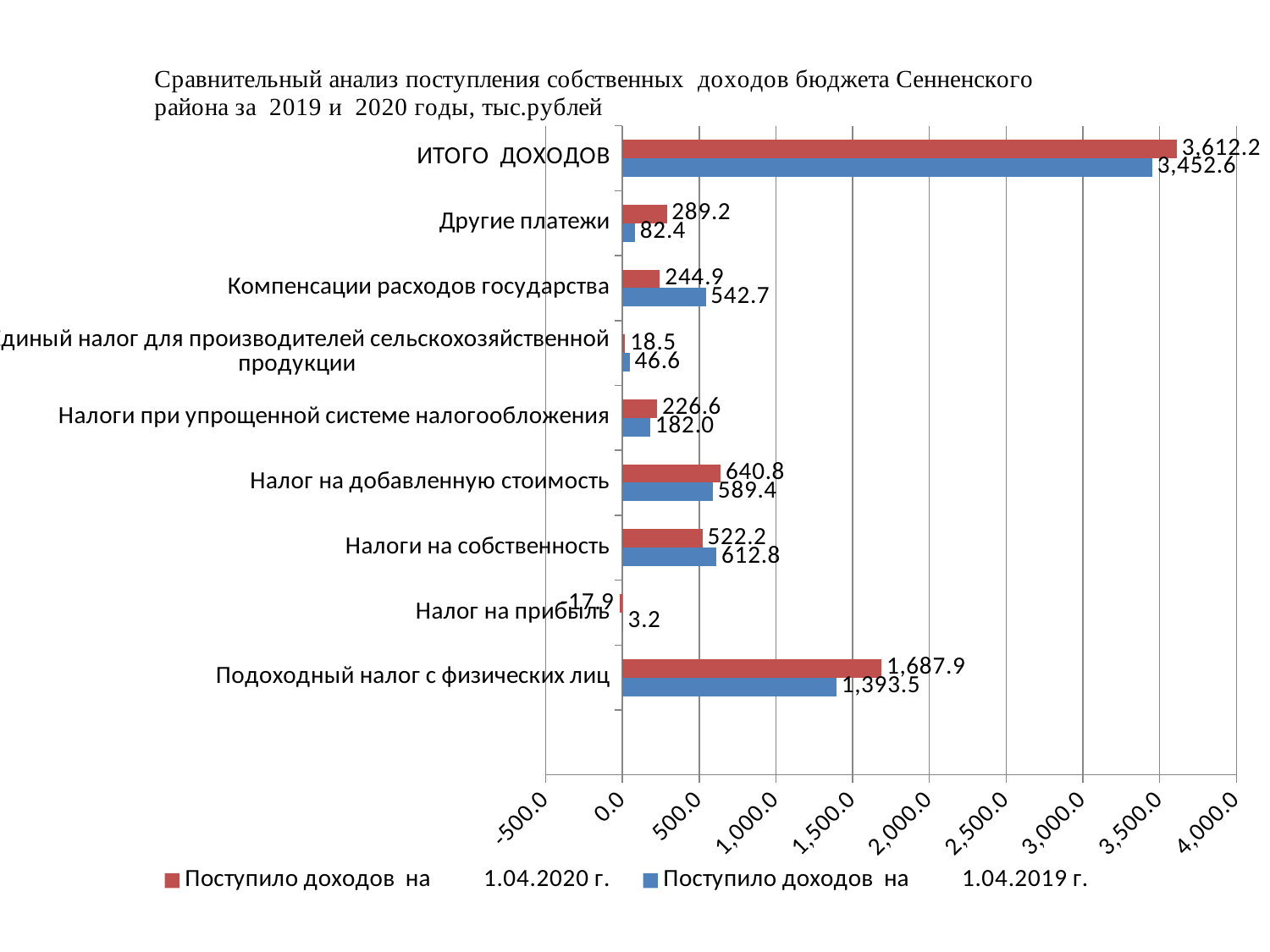
What is the value for Налог на прибыль in the series Поступило доходов на 1.04.2020 г.? -17.9 What is the value for Подоходный налог с физических лиц in the series Поступило доходов на 1.04.2019 г.? 1,393.5 What is the difference between the 1.04.2020 г. and 1.04.2019 г. values for Подоходный налог с физических лиц? 294.4 What is the value for Компенсации расходов государства in the series Поступило доходов на 1.04.2019 г.? 542.7 Which category has the lowest value in the series Поступило доходов на 1.04.2020 г.? Налог на прибыль For Налоги на собственность, which series has the larger value: Поступило доходов на 1.04.2020 г. or Поступило доходов на 1.04.2019 г.? Поступило доходов на 1.04.2019 г. What type of chart is shown on the slide? bar chart What colour are the bars for the series Поступило доходов на 1.04.2019 г.? blue How many categories are plotted on the chart? 9 What is the value for ИТОГО ДОХОДОВ in the series Поступило доходов на 1.04.2020 г.? 3,612.2 How many series does the legend list? 2 Which category has the highest value in the series Поступило доходов на 1.04.2019 г.? ИТОГО ДОХОДОВ